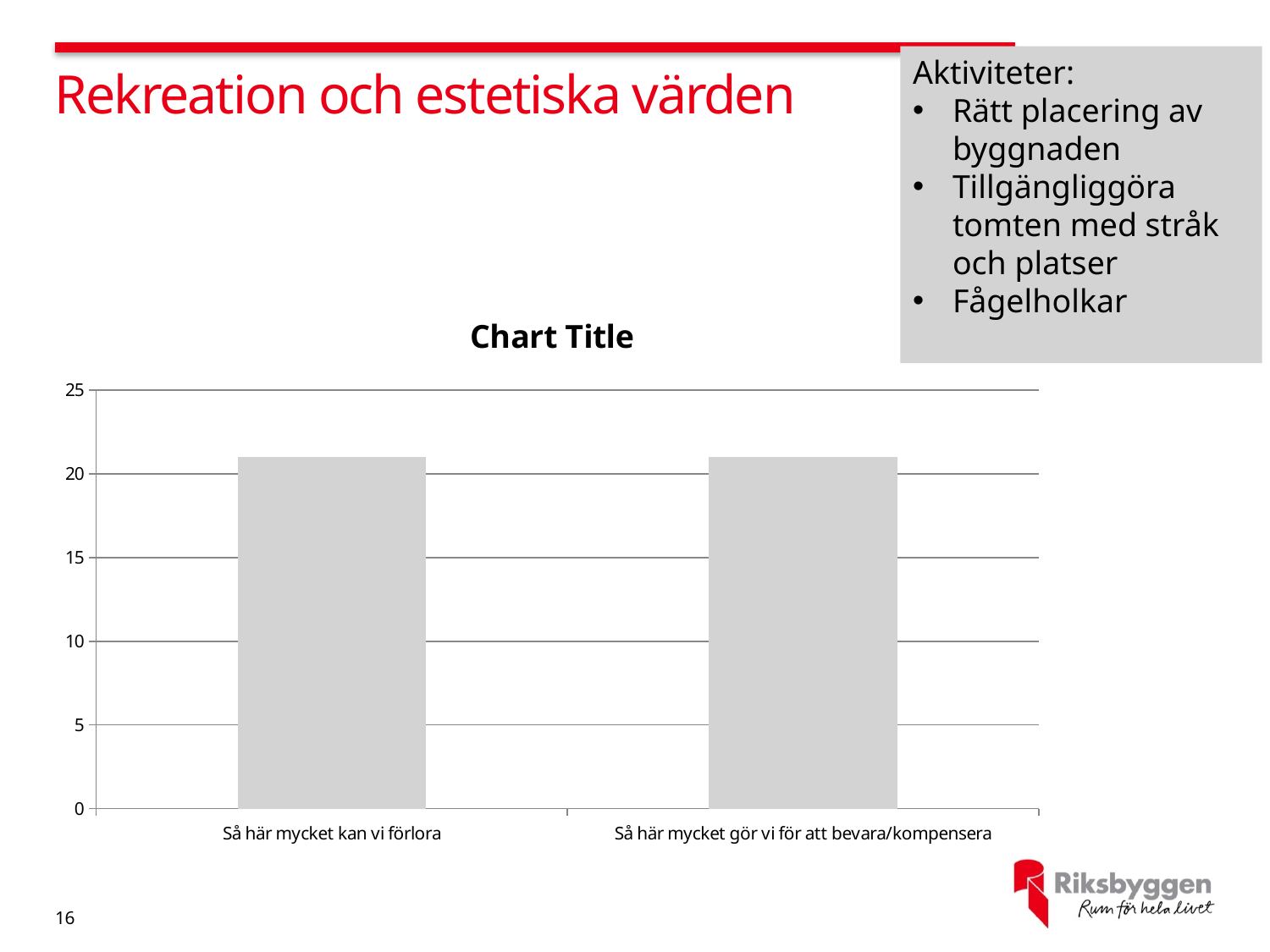
Is the value for "Så här mycket kan vi förlora" greater or less than 20? greater What is the title of the chart? Chart Title Is the value for "Så här mycket kan vi förlora" greater or less than 25? less Is the value for "Så här mycket gör vi för att bevara/kompensera" greater or less than 25? less What is the highest value shown on the chart's vertical axis? 25 How many categories are shown on the x axis of the chart? 2 What kind of chart is shown on the slide? bar chart